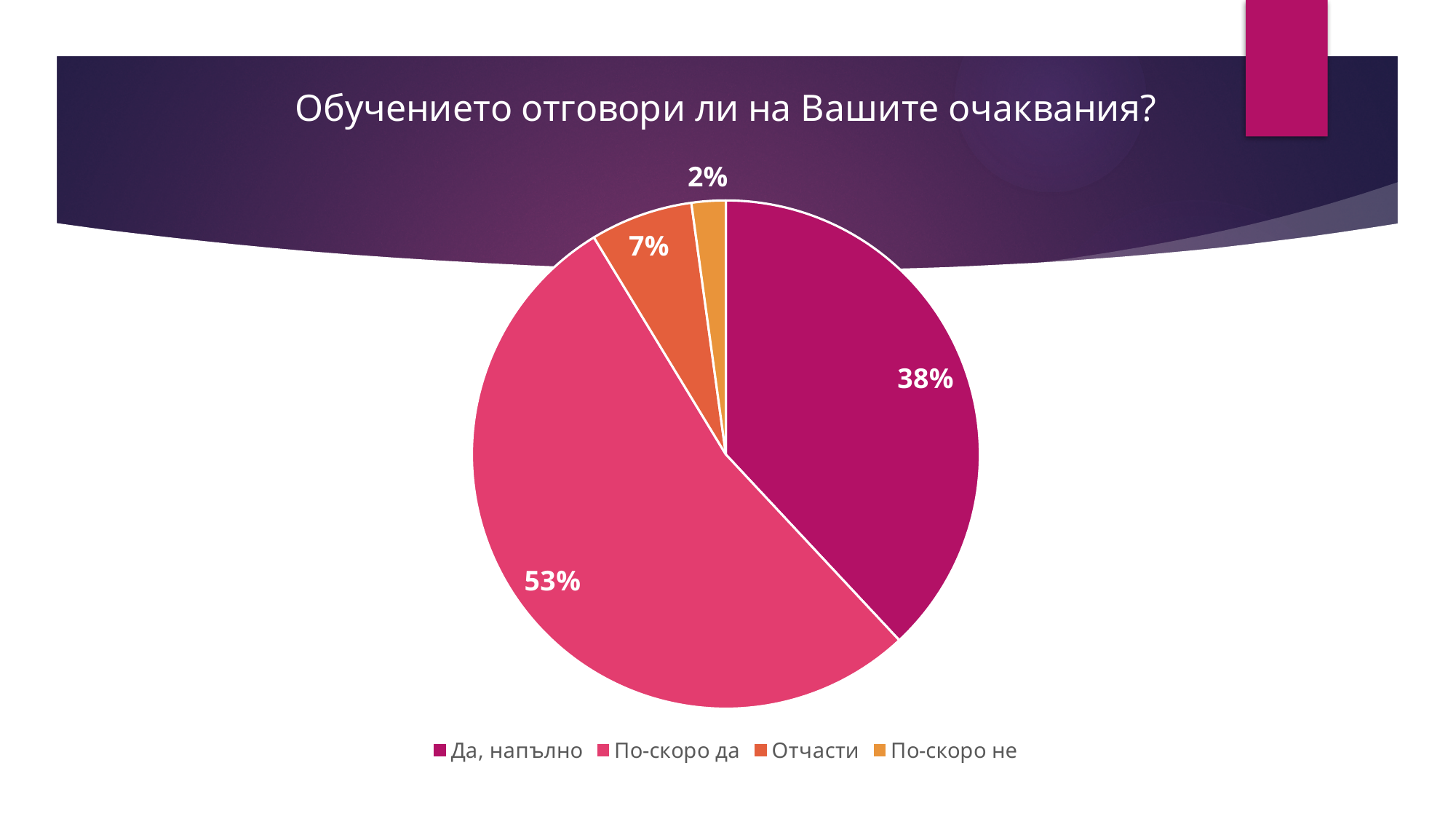
How many categories does the pie chart show? 4 What share of the pie does "По-скоро да" represent? 53% What is the difference between the shares of "По-скоро да" and "Да, напълно"? 15% What is the value for "Отчасти"? 7% What is the title of the chart? Обучението отговори ли на Вашите очаквания? Which category has the largest slice of the pie? По-скоро да What is the value for "По-скоро не"? 2% What share of the pie does "Да, напълно" represent? 38% What is the combined share of "Да, напълно" and "По-скоро да"? 91% Which category has the smallest slice of the pie? По-скоро не What kind of chart is shown on the slide? Pie chart Which is larger, the share for "Отчасти" or the share for "По-скоро не"? Отчасти